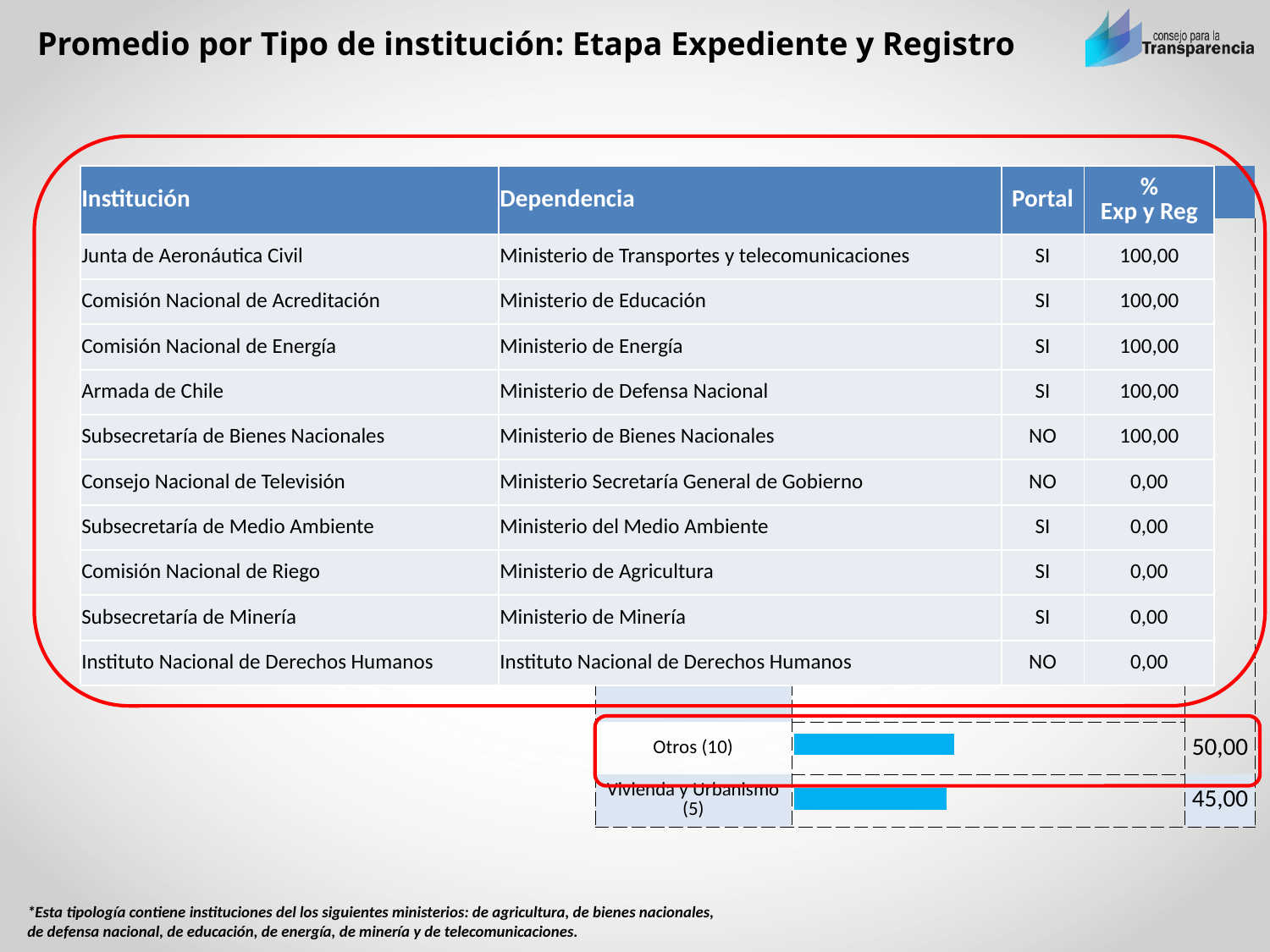
In the bar chart at the bottom of the slide, which has the larger value: Otros (10) or Vivienda y Urbanismo (5)? Otros (10) Are the bars in the chart at the bottom of the slide horizontal or vertical? Horizontal In the bar chart at the bottom of the slide, what is the difference between the values for Otros (10) and Vivienda y Urbanismo (5)? 5,00 In the bar chart at the bottom of the slide, what value is shown for Vivienda y Urbanismo (5)? 45,00 How many categories are visible in the bar chart at the bottom of the slide? 2 What kind of chart is shown at the bottom of the slide? Bar chart In the bar chart at the bottom of the slide, what value is shown for Otros (10)? 50,00 Of the two categories visible in the bar chart at the bottom of the slide, which has the lower value? Vivienda y Urbanismo (5)